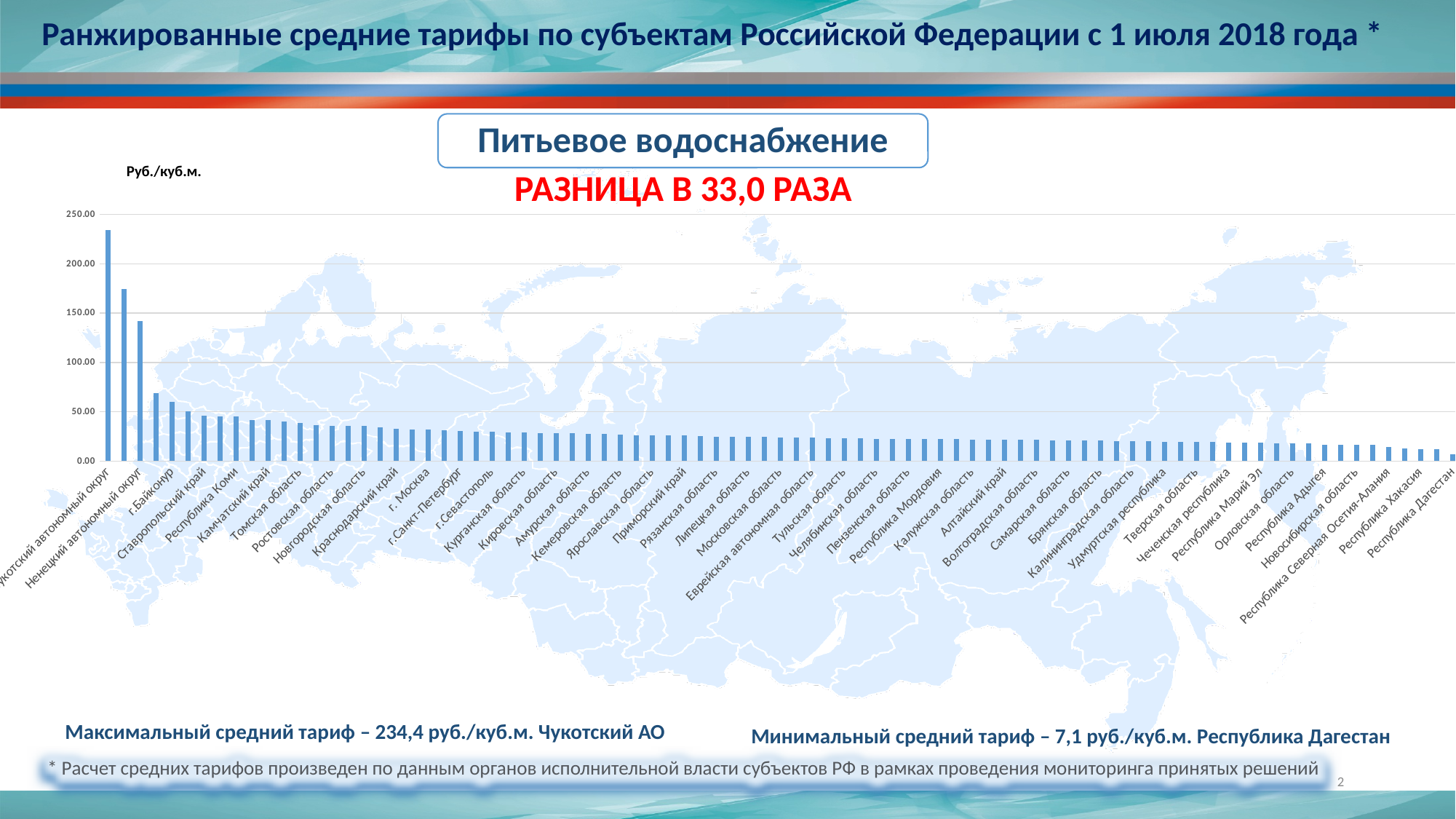
What kind of chart is shown on the slide? Bar chart Is the value for Ненецкий автономный округ greater or less than 100? greater What is the minimum average tariff shown for Республика Дагестан? 7,1 руб./куб.м. By how many times does the maximum tariff exceed the minimum, according to the slide? 33,0 раза Which region has the lowest average tariff in the chart? Республика Дагестан What is the difference between the maximum tariff (Чукотский АО) and the minimum tariff (Республика Дагестан)? 227,3 руб./куб.м. Which region has the highest average tariff in the chart? Чукотский автономный округ What is the maximum average tariff shown for Чукотский АО? 234,4 руб./куб.м. What unit is shown on the vertical axis of the chart? Руб./куб.м. Which is larger, the tariff for Чукотский АО or for Республика Дагестан? Чукотский АО Do the bar values rise or fall from left to right along the x axis? Fall